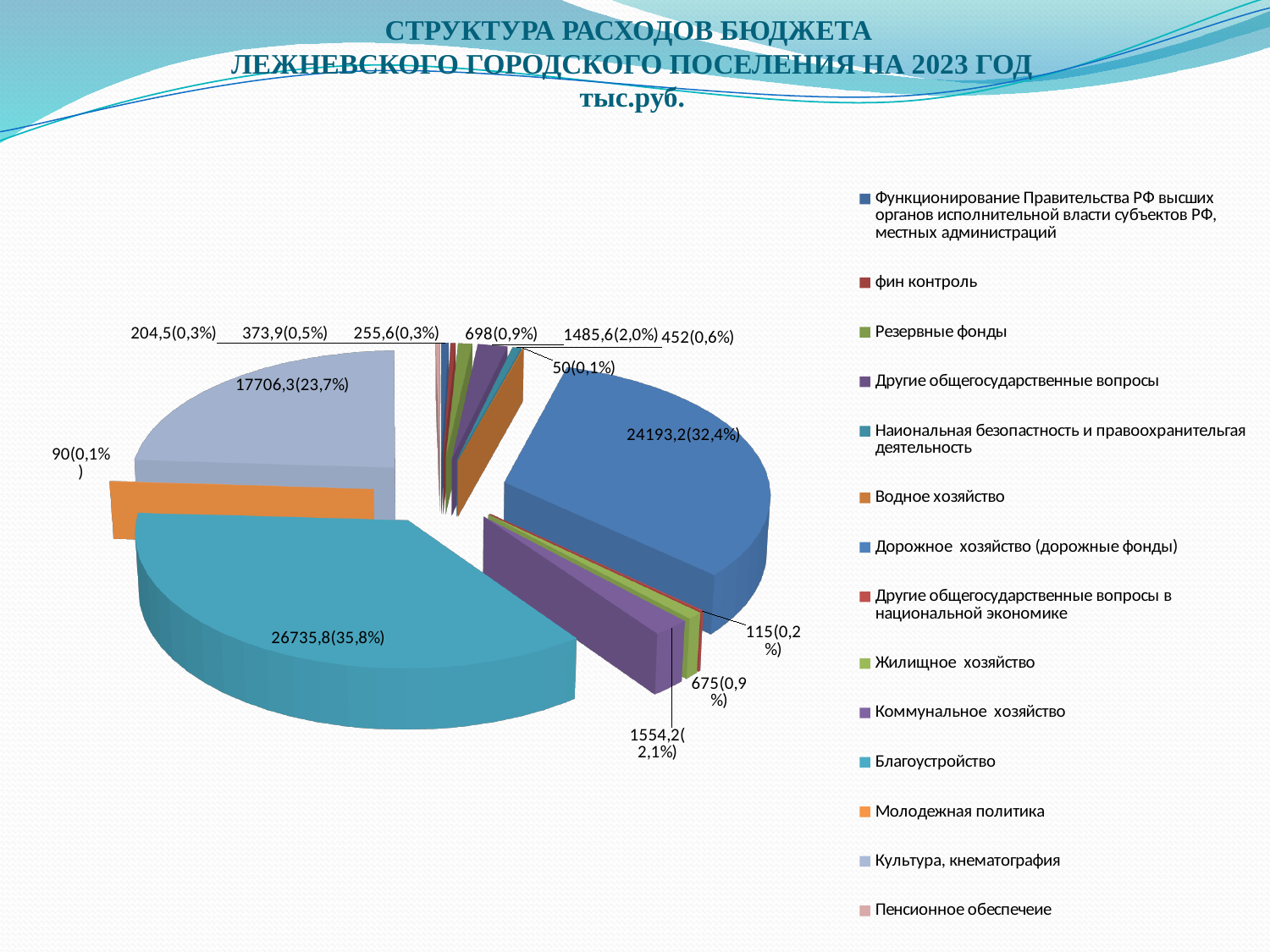
What share of the pie does Благоустройство take? 35,8% What kind of chart is shown on the slide? pie chart How many categories does the legend of the pie chart list? 14 What is the difference between the value for Благоустройство (26735,8) and the value for Дорожное хозяйство (24193,2)? 2542,6 Which is larger: the slice for Дорожное хозяйство (дорожные фонды) or the slice for Культура, кнематография? Дорожное хозяйство (дорожные фонды) What share of the pie does Культура, кнематография take? 23,7% What is the smallest value printed on a data label in the pie chart? 50 What value is shown for Дорожное хозяйство (дорожные фонды)? 24193,2 What value is printed on the largest slice of the pie chart? 26735,8(35,8%) In what units are the values on the slide expressed, according to the title? тыс.руб. Which category has the largest slice in the pie chart? Благоустройство What share of the pie does Коммунальное хозяйство take? 2,1%